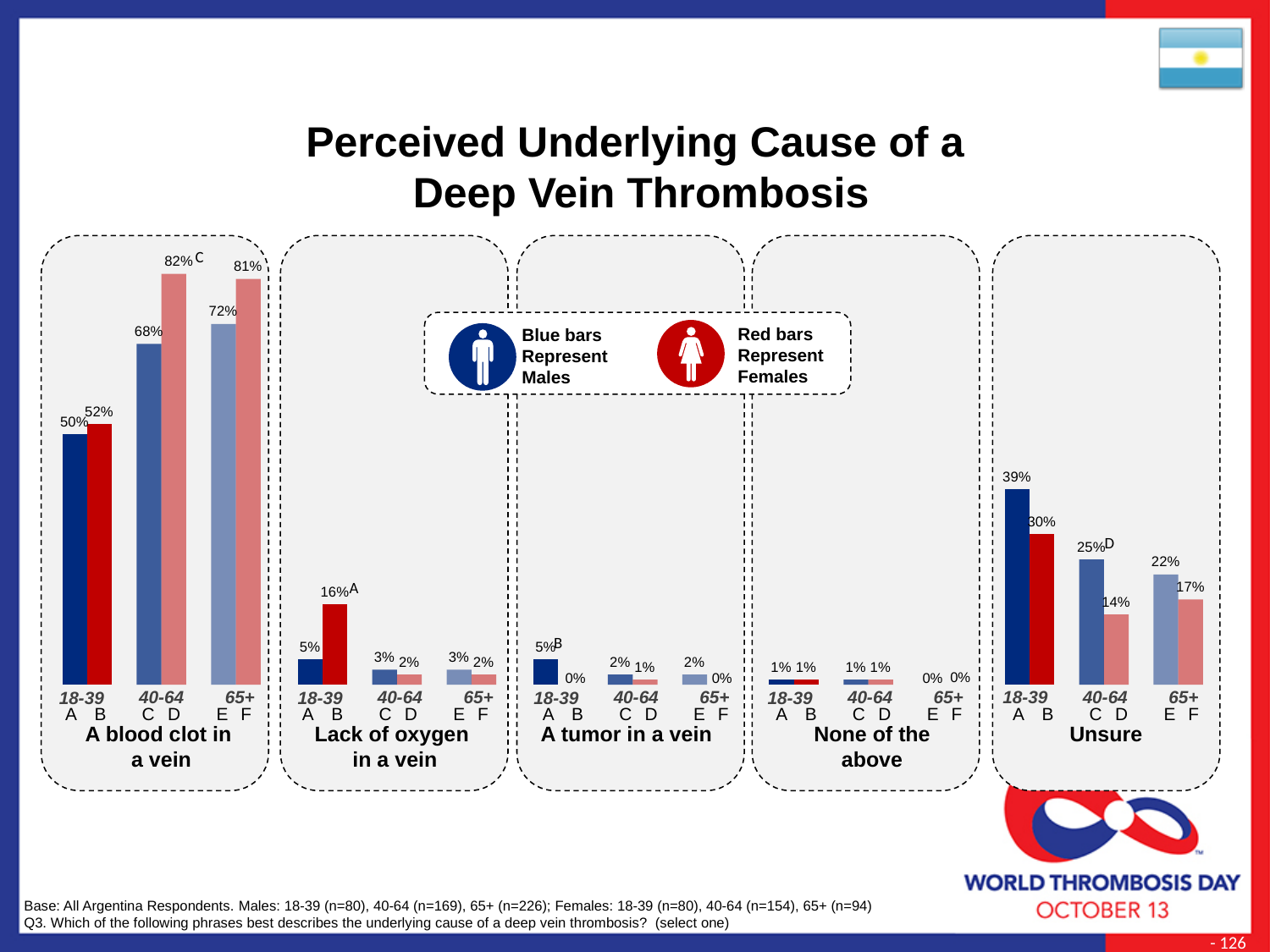
What percentage of males aged 65+ chose 'A blood clot in a vein'? 72% Within 'A blood clot in a vein', which age and gender group has the highest value? Females 40-64 What percentage of males aged 18-39 answered 'Unsure'? 39% How many response categories (panels) are shown on the chart? 5 What is the difference between females and males aged 40-64 for 'A blood clot in a vein'? 14 percentage points For 'Lack of oxygen in a vein', which is larger: males 18-39 or females 18-39? Females 18-39 Within 'Unsure', which age and gender group has the lowest value? Females 40-64 According to the legend, what do the red bars represent? Females What type of chart is shown on the slide? Bar chart What percentage of females aged 18-39 chose 'Lack of oxygen in a vein'? 16% What percentage of females aged 40-64 perceive 'A blood clot in a vein' as the underlying cause of a deep vein thrombosis? 82% What is the difference between males and females aged 18-39 for 'Unsure'? 9 percentage points